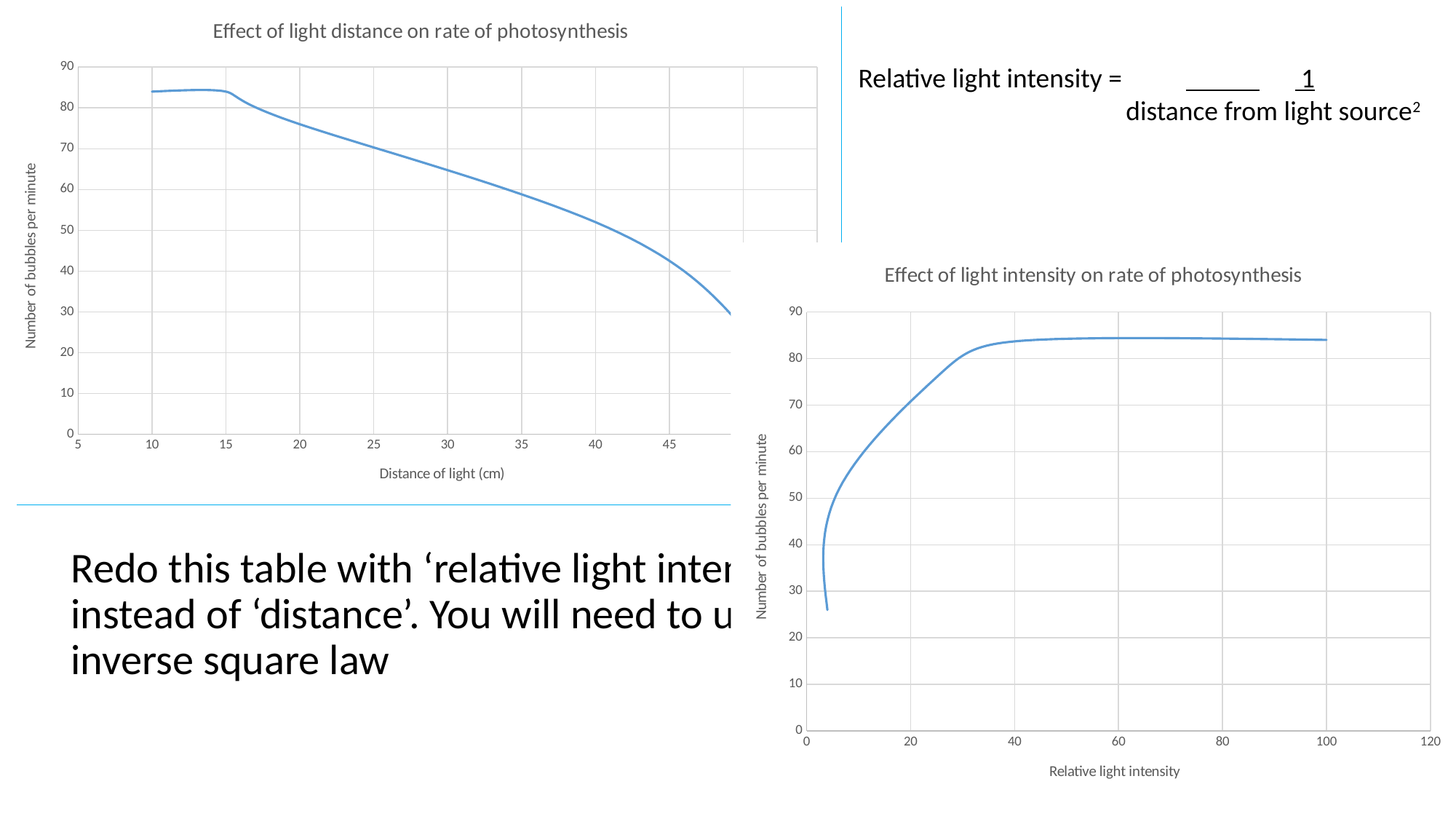
What kind of chart is the 'Effect of light intensity on rate of photosynthesis' chart? line chart In the 'Effect of light intensity on rate of photosynthesis' chart, do the values rise or fall as relative light intensity increases from 0 to 40? rise In the 'Effect of light distance on rate of photosynthesis' chart, do the values rise or fall as distance of light increases? fall What is the x-axis label of the 'Effect of light distance on rate of photosynthesis' chart? Distance of light (cm) In the 'Effect of light distance on rate of photosynthesis' chart, is the number of bubbles per minute at a distance of 30 cm greater or less than 60? greater In the 'Effect of light distance on rate of photosynthesis' chart, is the number of bubbles per minute at a distance of 10 cm greater or less than 80? greater In the 'Effect of light distance on rate of photosynthesis' chart, is the value at 10 cm larger or smaller than the value at 40 cm? larger In the 'Effect of light intensity on rate of photosynthesis' chart, is the number of bubbles per minute at a relative light intensity of 60 greater or less than 80? greater What is the y-axis label of the 'Effect of light intensity on rate of photosynthesis' chart? Number of bubbles per minute What kind of chart is the 'Effect of light distance on rate of photosynthesis' chart? line chart